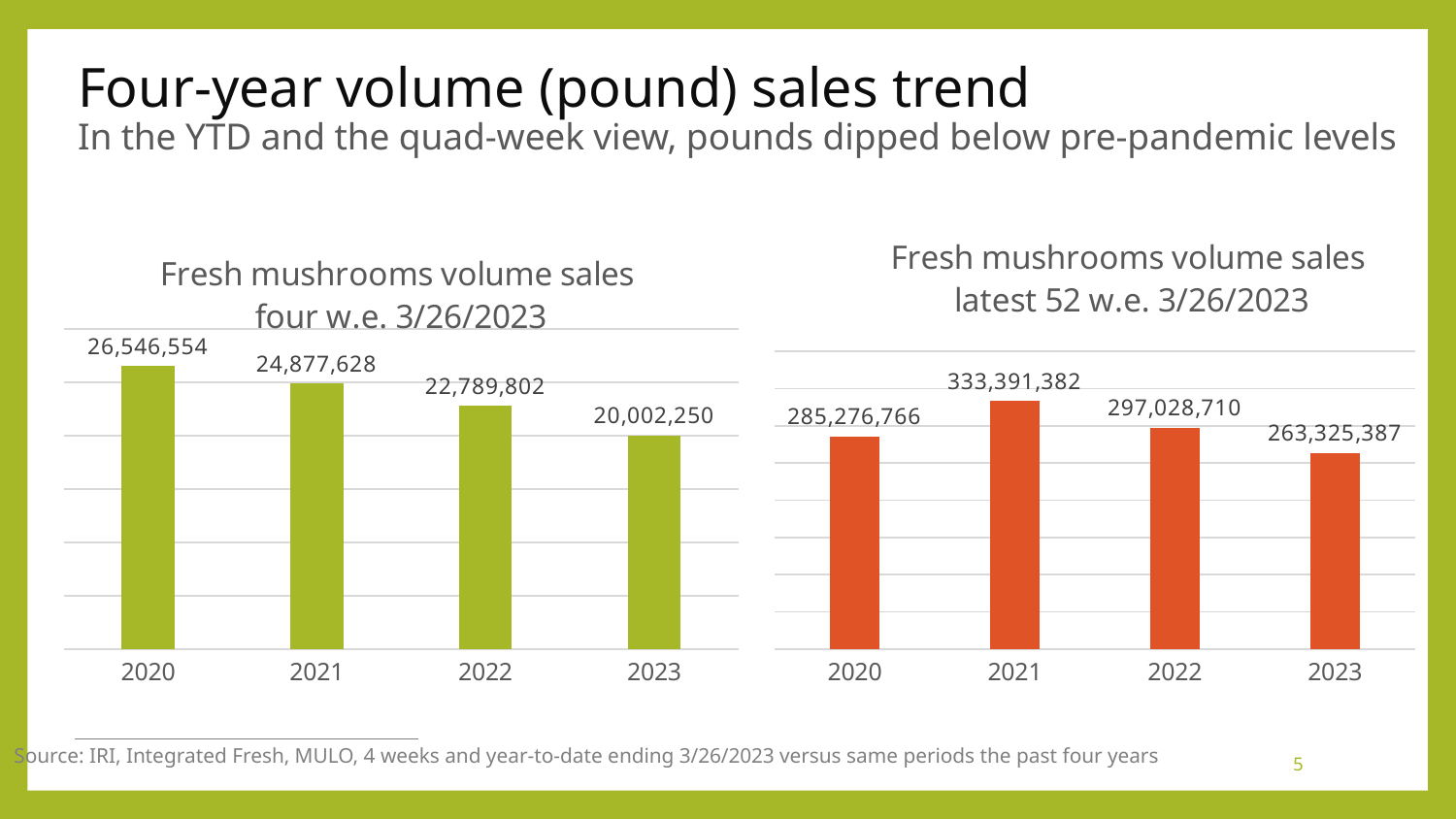
In the 'Fresh mushrooms volume sales latest 52 w.e. 3/26/2023' chart, how much higher is 2021 than 2020? 48,114,616 How many years are shown in the 'Fresh mushrooms volume sales four w.e. 3/26/2023' chart? 4 In the 'Fresh mushrooms volume sales latest 52 w.e. 3/26/2023' chart, which is larger, the value for 2020 or 2022? 2022 In the 'Fresh mushrooms volume sales four w.e. 3/26/2023' chart, do the values rise or fall from 2020 to 2023? Fall In the 'Fresh mushrooms volume sales four w.e. 3/26/2023' chart, what is the difference between the 2020 and 2023 values? 6,544,304 In the 'Fresh mushrooms volume sales four w.e. 3/26/2023' chart, which year has the highest value? 2020 What kind of chart is the 'Fresh mushrooms volume sales latest 52 w.e. 3/26/2023' chart? Bar chart In the 'Fresh mushrooms volume sales latest 52 w.e. 3/26/2023' chart, what is the value for 2022? 297,028,710 In the 'Fresh mushrooms volume sales latest 52 w.e. 3/26/2023' chart, which year has the lowest value? 2023 In the 'Fresh mushrooms volume sales four w.e. 3/26/2023' chart, what is the value for 2023? 20,002,250 What colour are the bars in the 'Fresh mushrooms volume sales four w.e. 3/26/2023' chart? Green In the 'Fresh mushrooms volume sales latest 52 w.e. 3/26/2023' chart, what is the value for 2021? 333,391,382